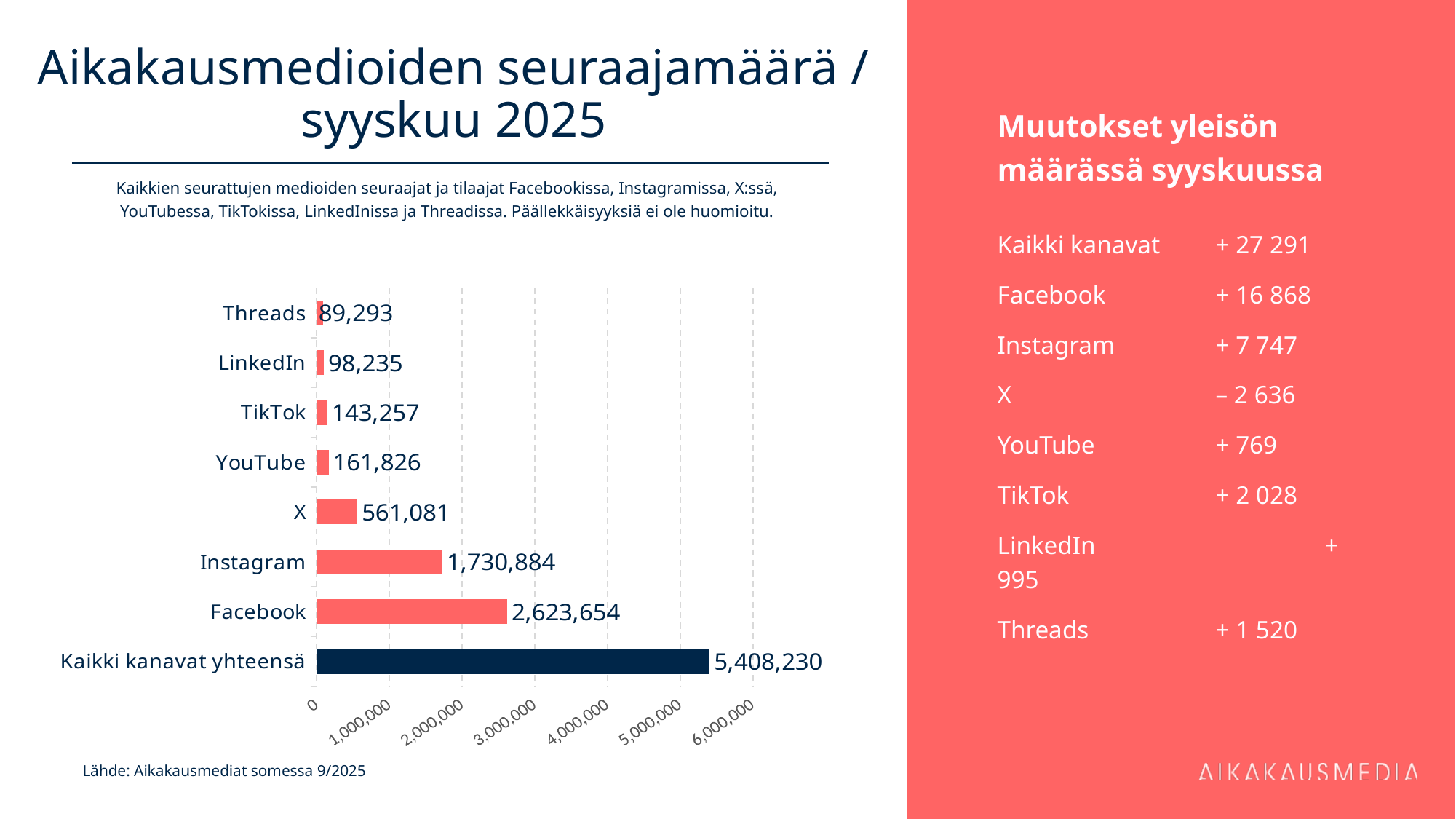
Which individual channel (excluding the total bar) has the highest value in the chart? Facebook What kind of chart is shown on the slide? Bar chart What is the difference between the YouTube and TikTok values in the chart? 18,569 Which category has the lowest value in the chart? Threads What is the value shown for X in the chart? 561,081 How many bars are shown in the chart? 8 What is the value shown for Instagram in the chart? 1,730,884 What is the value shown for 'Kaikki kanavat yhteensä' in the chart? 5,408,230 Which is larger in the chart, the value for LinkedIn or the value for TikTok? TikTok What is the value shown for Threads in the chart? 89,293 What is the difference between the Facebook and Instagram values in the chart? 892,770 What is the value shown for Facebook in the chart? 2,623,654